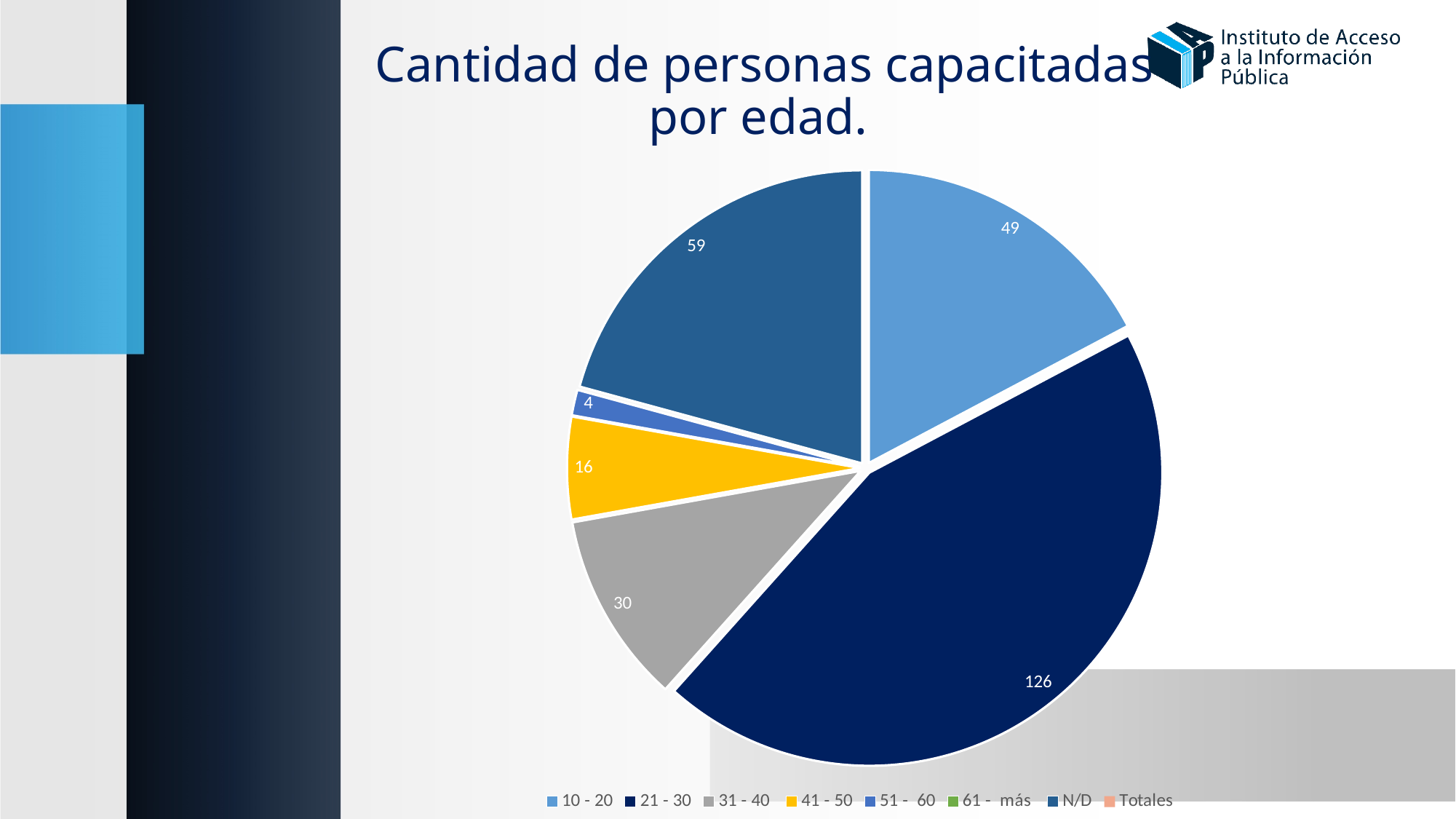
Which labelled slice has the smallest value? 51 - 60 What is the difference between the 31 - 40 value and the 41 - 50 value? 14 What is the value for the 21 - 30 age group? 126 What is the value for the 41 - 50 age group? 16 What is the value for the 10 - 20 age group? 49 What type of chart is shown on the slide? pie chart What is the value for the N/D category? 59 What is the title of the chart? Cantidad de personas capacitadas por edad. What is the difference between the 21 - 30 value and the 10 - 20 value? 77 How many entries does the chart legend list? 8 Which age group has the largest slice of the pie? 21 - 30 Which is larger, the value for N/D or the value for 10 - 20? N/D